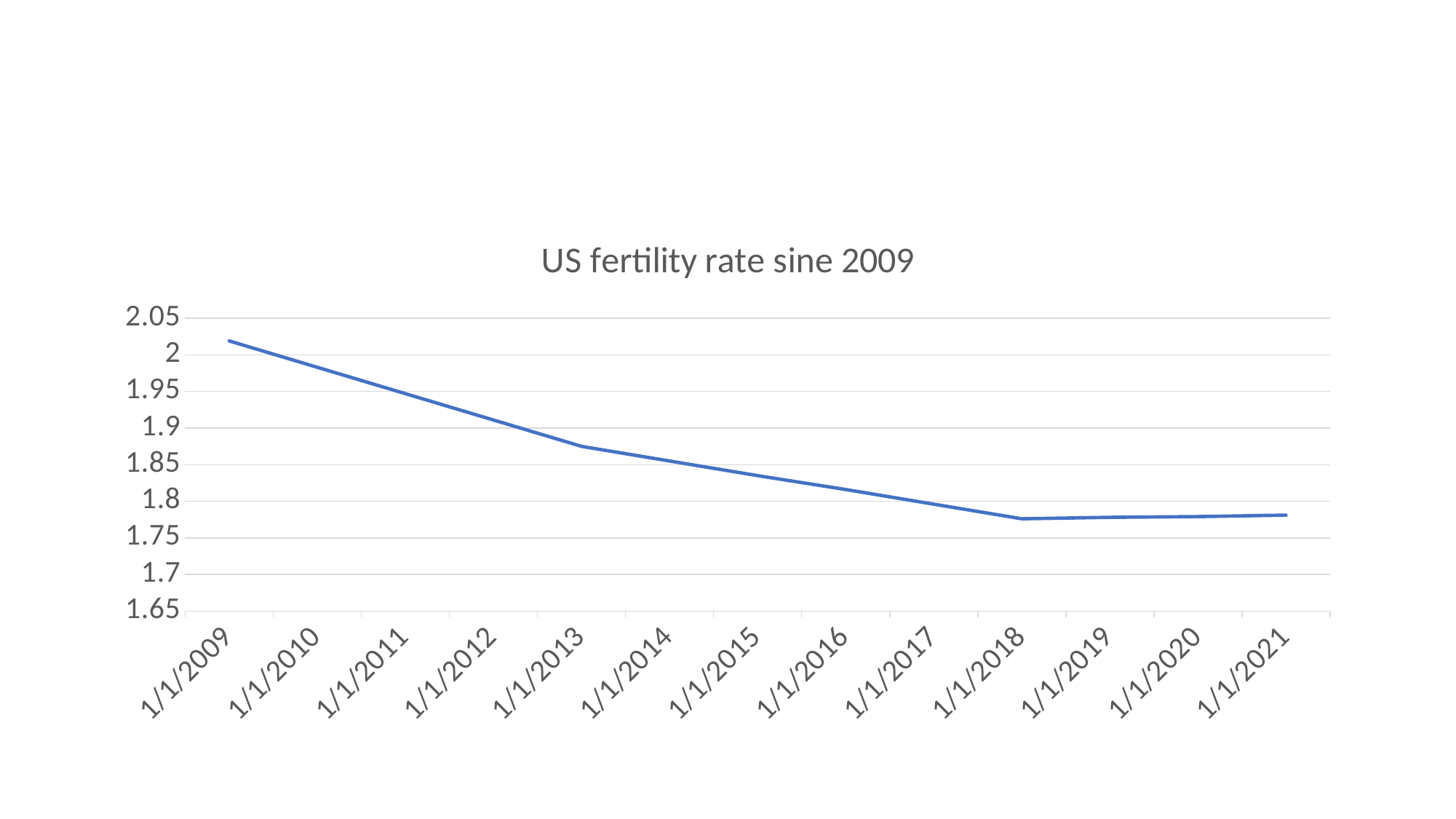
How many data points are plotted along the x axis? 13 Which date has the highest value on the chart? 1/1/2009 Is the value for 1/1/2011 greater or less than 1.9? greater Do the values generally rise or fall from 1/1/2009 to 1/1/2018? fall What kind of chart is shown on the slide? line chart Is the value for 1/1/2018 greater or less than 1.8? less Which is larger, the value for 1/1/2013 or the value for 1/1/2017? 1/1/2013 Is the value for 1/1/2013 greater or less than 1.9? less Which is larger, the value for 1/1/2009 or the value for 1/1/2021? 1/1/2009 What is the title of the chart? US fertility rate sine 2009